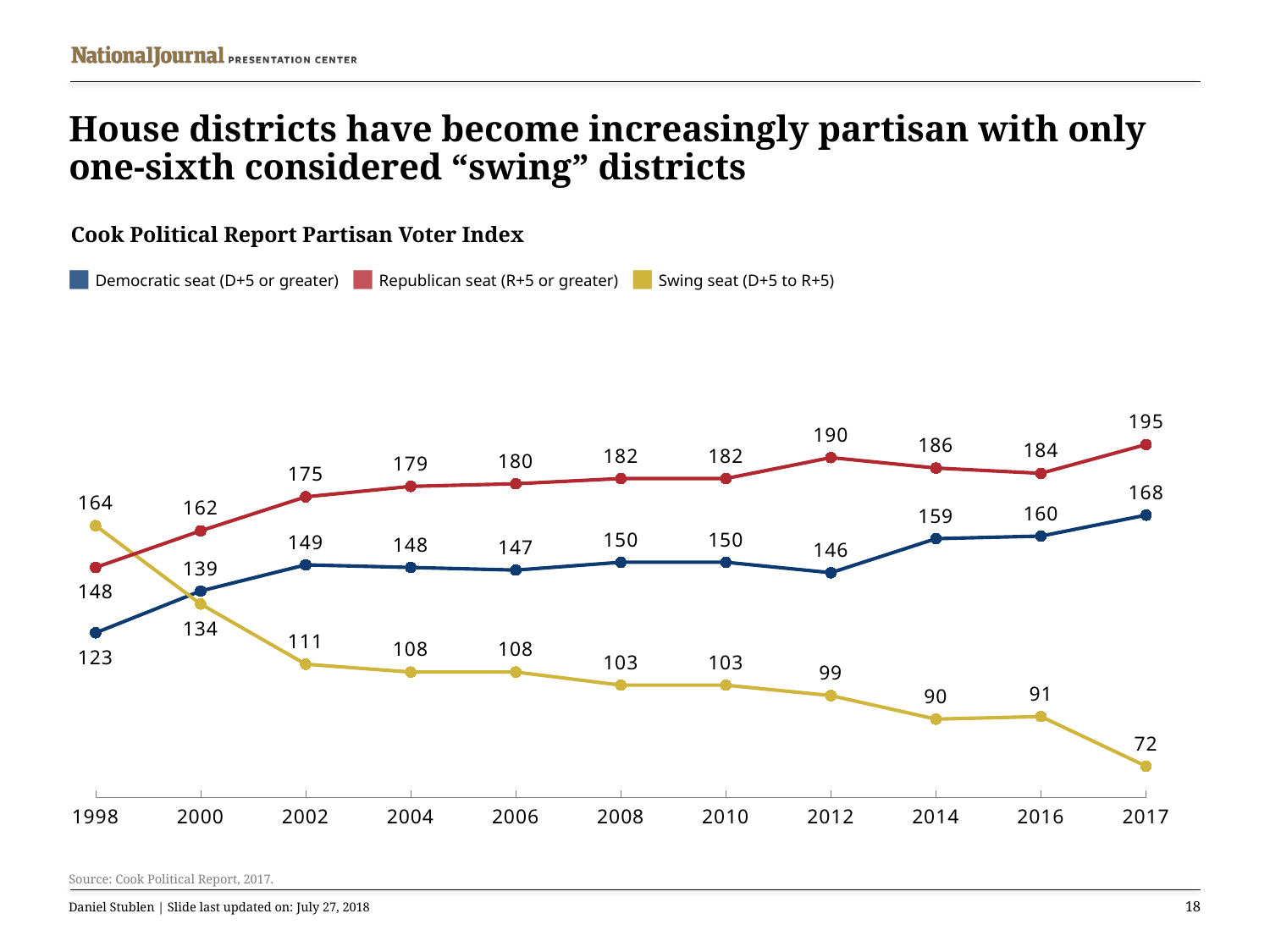
How many series does the legend list? 3 What is the value for Democratic seat in 2012? 146 What kind of chart is shown on the slide? Line chart Does the Swing seat series generally rise or fall from 1998 to 2017? Fall What is the difference between the Republican seat and Democratic seat values in 2017? 27 How many years are plotted along the x axis? 11 Which is larger in 1998, the Swing seat value or the Democratic seat value? Swing seat What is the value for Republican seat in 2017? 195 What is the title of the chart? Cook Political Report Partisan Voter Index What is the value for Swing seat in 1998? 164 In which year is the Republican seat value highest? 2017 In which year is the Swing seat value lowest? 2017